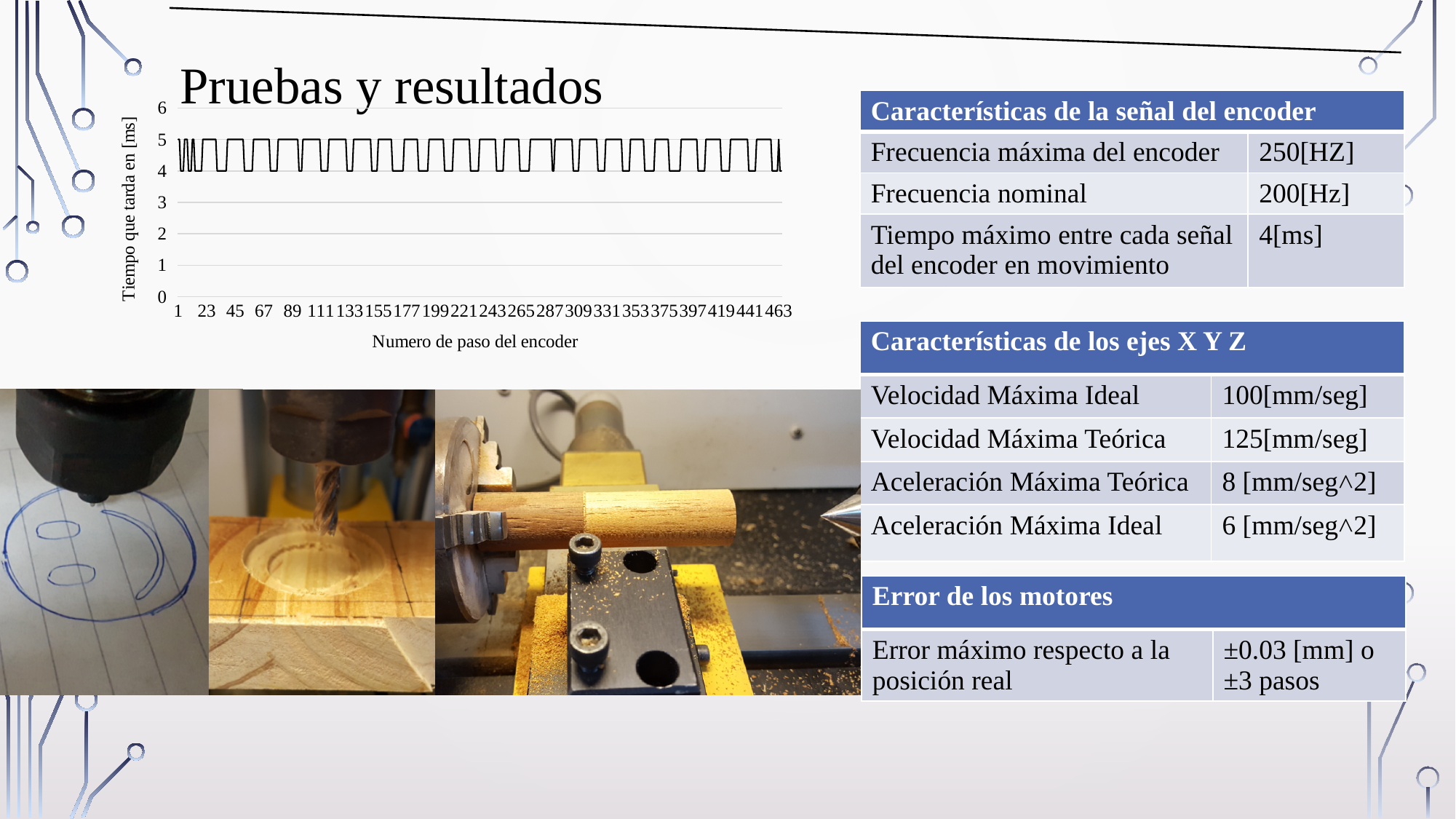
Is the value at encoder step 111 greater or less than 1? greater Is the value at encoder step 463 greater or less than 6? less What is the label of the y axis of the chart? Tiempo que tarda en [ms] Is the value at encoder step 331 greater or less than 6? less What kind of chart is shown on the slide? line chart What is the highest tick value shown on the y axis of the chart? 6 What is the label of the x axis of the chart? Numero de paso del encoder